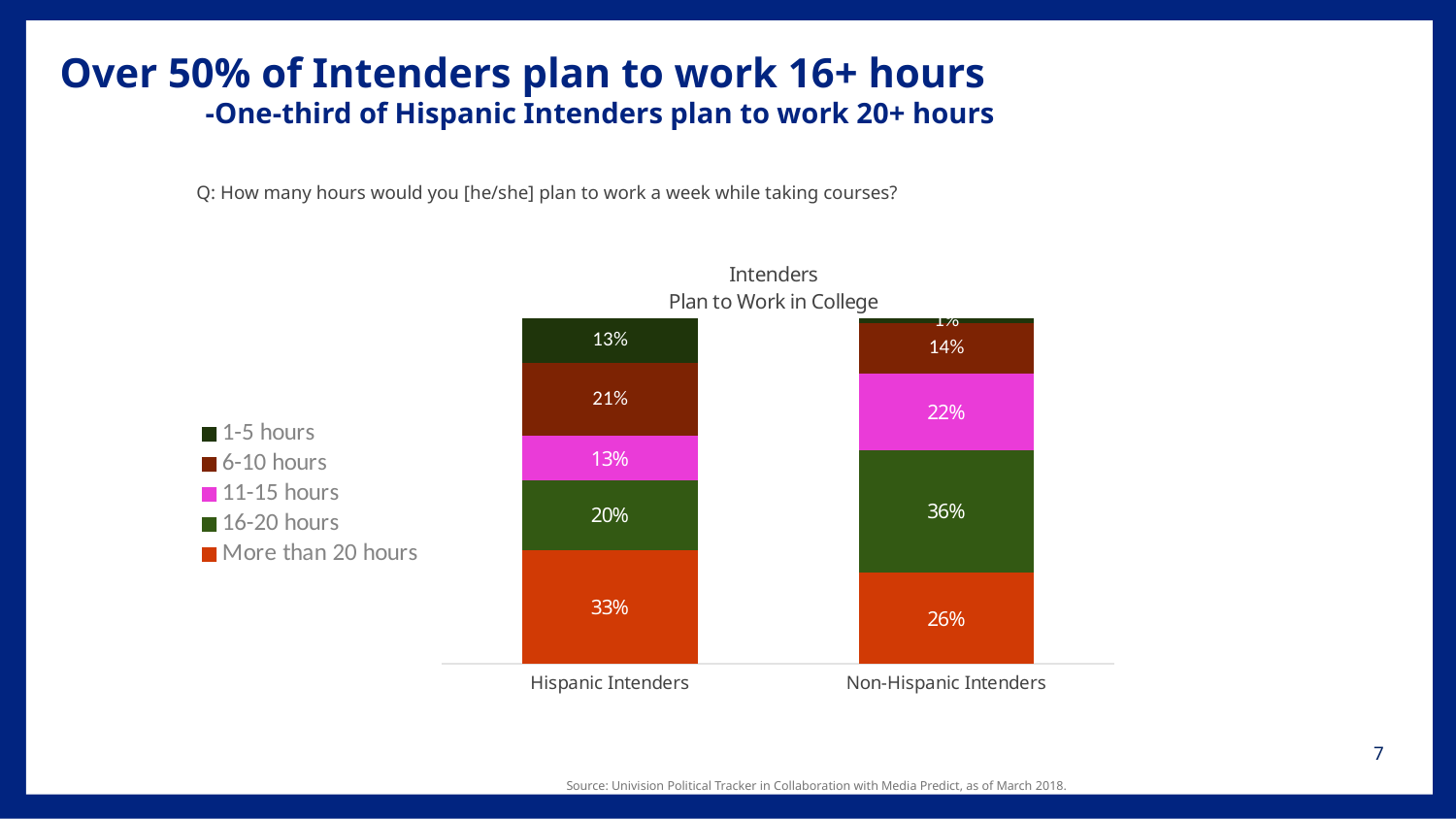
Which group has the larger share planning to work more than 20 hours, Hispanic Intenders or Non-Hispanic Intenders? Hispanic Intenders What percentage of Non-Hispanic Intenders plan to work 16-20 hours? 36% What percentage of Hispanic Intenders plan to work more than 20 hours? 33% What is the value for 11-15 hours among Non-Hispanic Intenders? 22% How many series does the legend list? 5 Which hours category is the largest segment in the Non-Hispanic Intenders bar? 16-20 hours Which hours category is the largest segment in the Hispanic Intenders bar? More than 20 hours What is the value for 6-10 hours among Hispanic Intenders? 21% How many percentage points higher is the 16-20 hours share for Non-Hispanic Intenders than for Hispanic Intenders? 16 percentage points What kind of chart is shown on the slide? Stacked bar chart How many groups (bars) are shown on the x axis? 2 What is the total of the Hispanic Intenders stacked bar? 100%